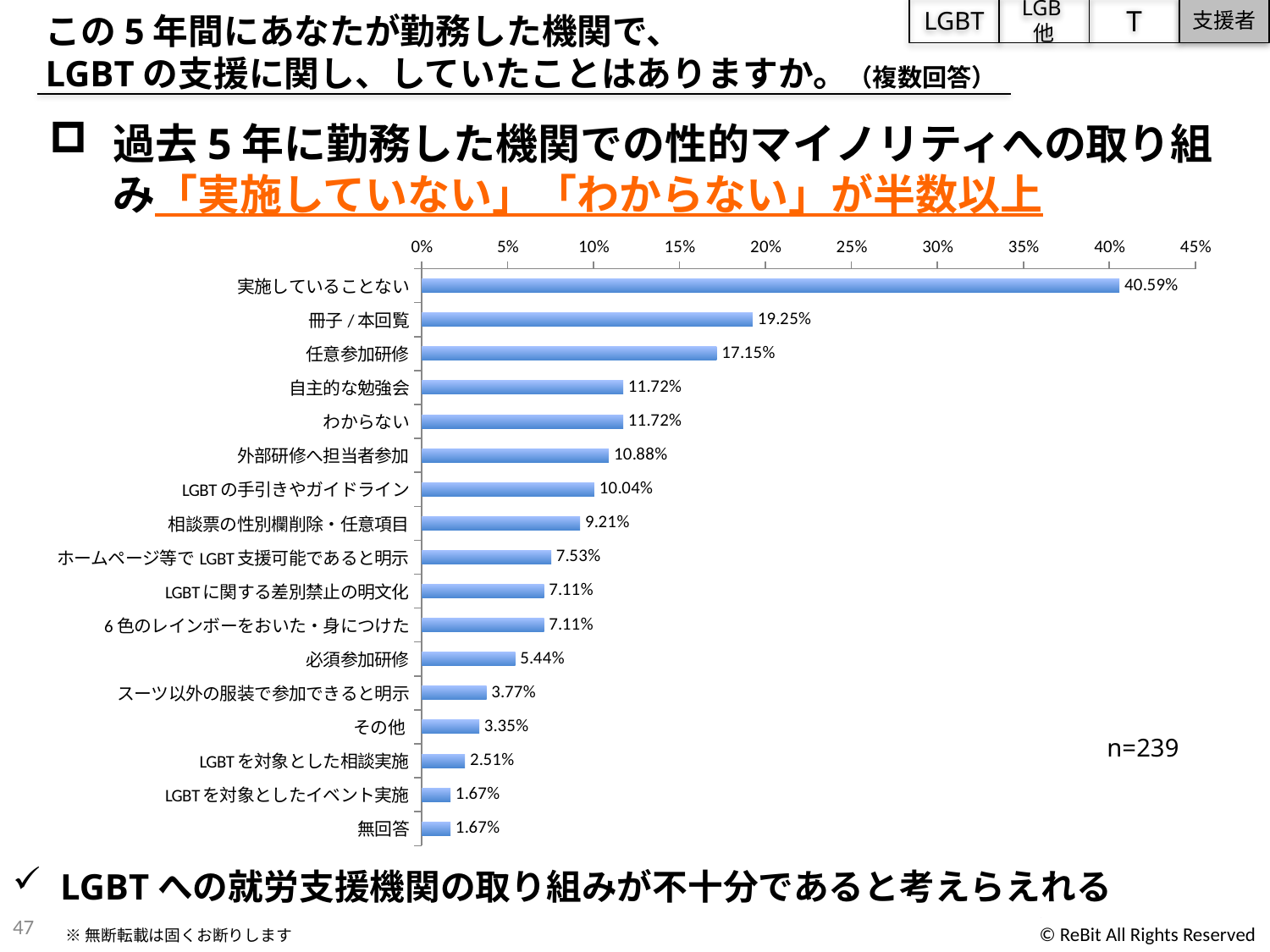
What is the difference between 実施していることない and 冊子／本回覧? 21.34% What is the value for 必須参加研修? 5.44% Is the value for 任意参加研修 greater or less than 15%? greater Which is larger, 任意参加研修 or 外部研修へ担当者参加? 任意参加研修 What is the value for わからない? 11.72% What is the value for 冊子／本回覧? 19.25% How many categories are shown in the chart? 17 What is the maximum value shown on the percentage axis? 45% What is the sample size (n) shown next to the chart? n=239 Which category has the highest value? 実施していることない What is the value for 実施していることない? 40.59% What kind of chart is shown on the slide? bar chart